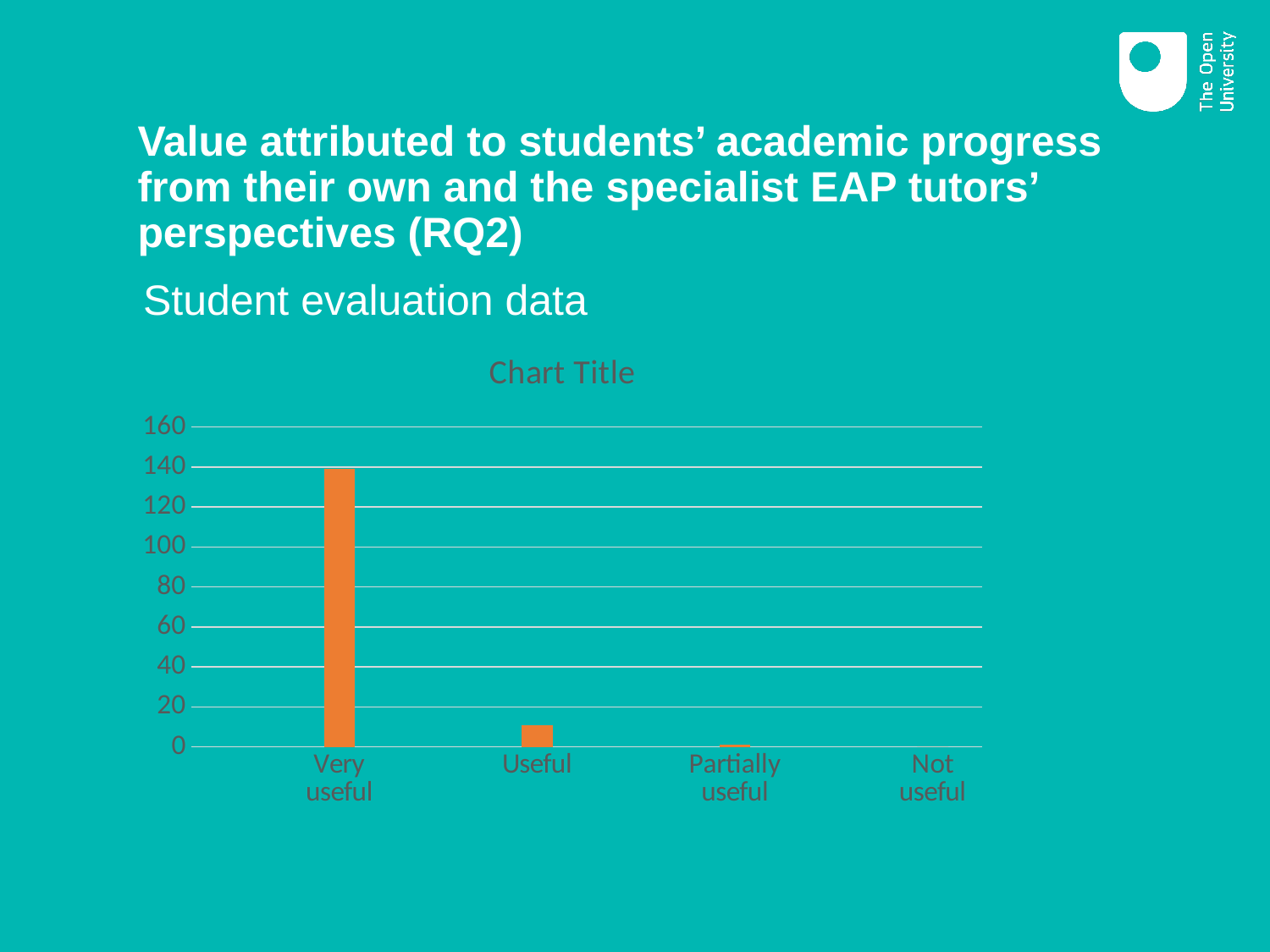
What kind of chart is shown on the slide? bar chart What colour are the bars in the chart? orange Which is larger, the value for Very useful or the value for Useful? Very useful Which category has the highest value in the chart? Very useful How many categories are shown on the x axis of the chart? 4 Is the value for Useful greater or less than 20? less Is the value for Very useful greater or less than 120? greater Is the value for Partially useful greater or less than 20? less Do the values rise or fall moving from left to right along the x axis? fall What is the title shown above the chart? Chart Title Which is larger, the value for Useful or the value for Partially useful? Useful